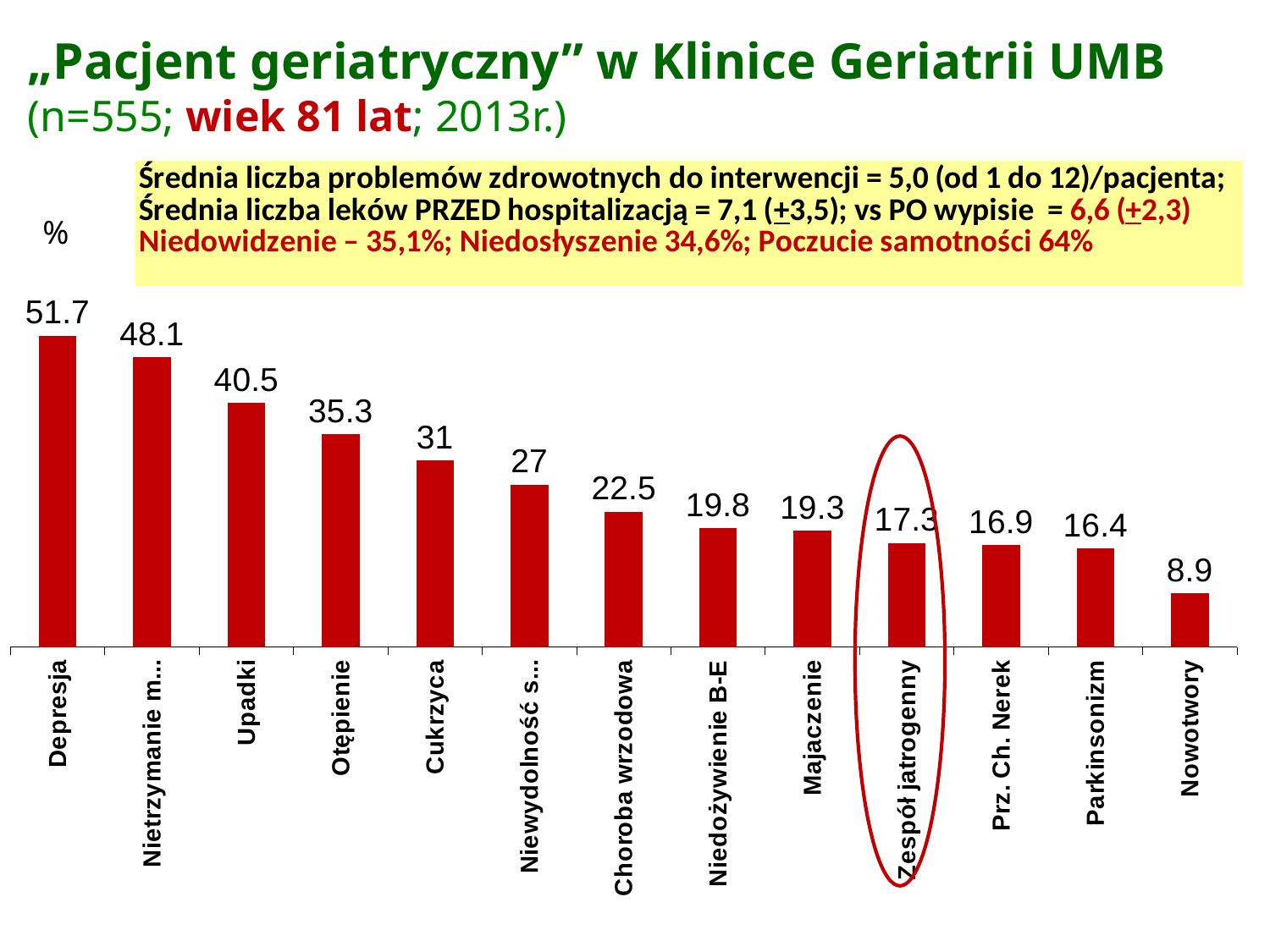
Which is larger, the value for Choroba wrzodowa or the value for Majaczenie? Choroba wrzodowa Which category on the chart is circled in red? Zespół jatrogenny What is the value for Upadki? 40.5 How many categories are shown in the chart? 13 What is the value for Zespół jatrogenny? 17.3 Which category has the highest value? Depresja What is the difference between the values for Otępienie and Cukrzyca? 4.3 What is the value for Nowotwory? 8.9 Do the values rise or fall from left to right along the x axis? Fall What is the value for Depresja? 51.7 Which category has the lowest value? Nowotwory What kind of chart is shown on the slide? Bar chart